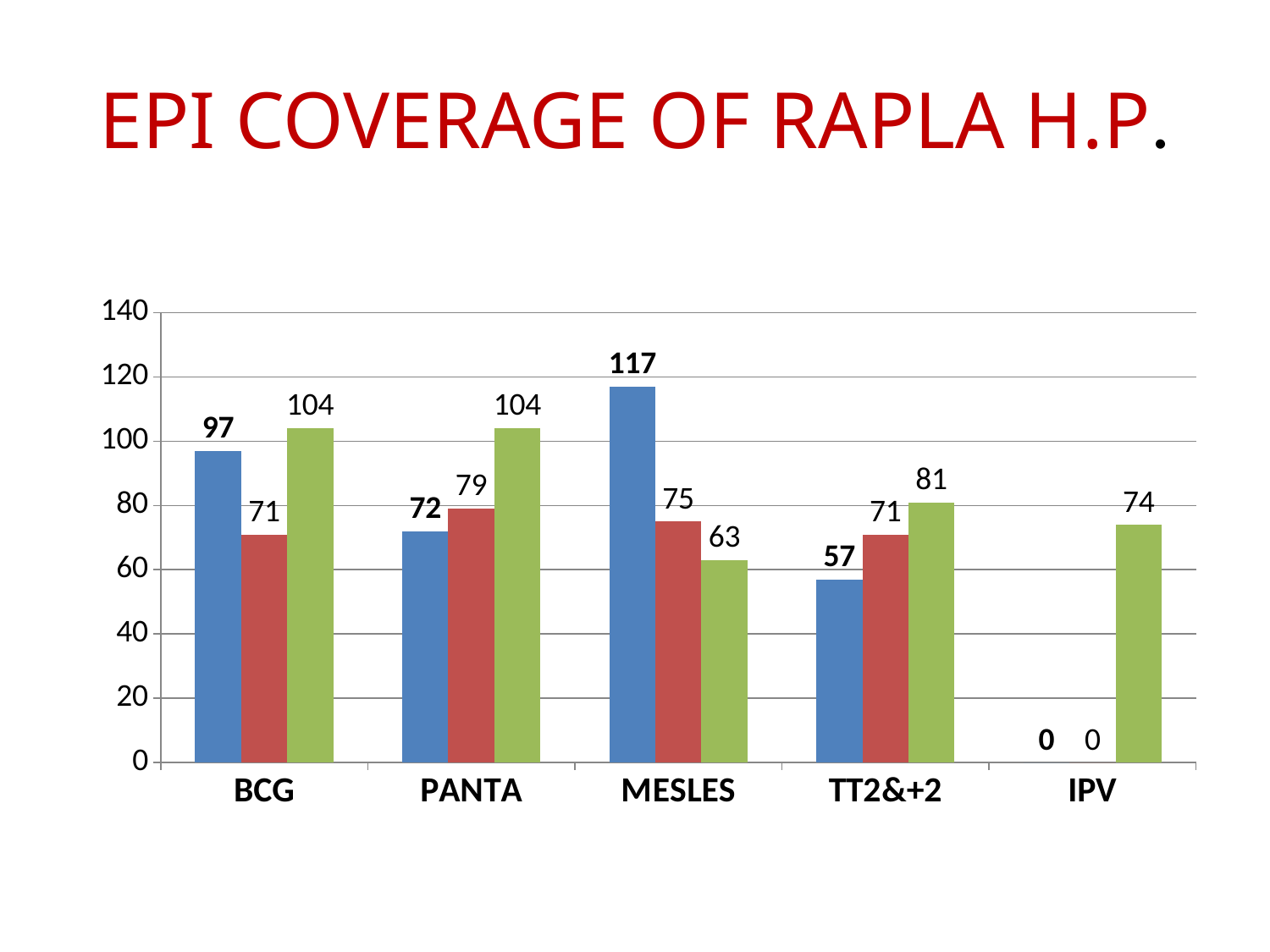
Is the value of the blue bar for BCG greater or less than 100? less What is the value of the green bar for IPV? 74 What is the difference between the blue bar for MESLES and the blue bar for TT2&+2? 60 What is the title of the slide? EPI COVERAGE OF RAPLA H.P. How many categories are shown on the x axis? 5 What kind of chart is shown on the slide? bar chart What is the value of the blue bar for BCG? 97 What is the value of the green bar for PANTA? 104 Which category has the highest blue bar? MESLES Which category has the lowest green bar? MESLES Which is larger for TT2&+2, the red bar or the green bar? the green bar What is the value of the red bar for MESLES? 75